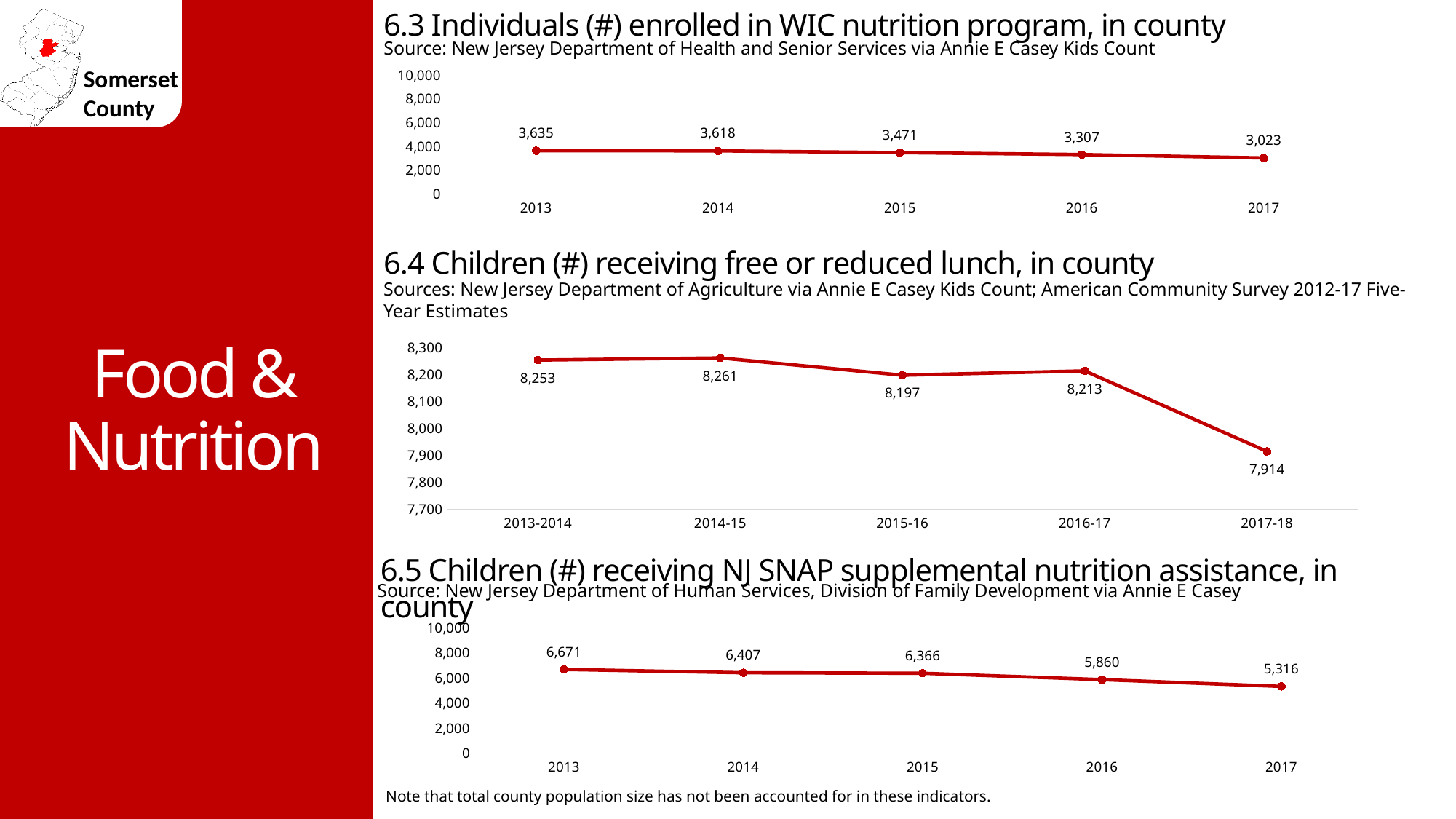
In the chart '6.5 Children (#) receiving NJ SNAP supplemental nutrition assistance, in county', what is the value for 2014? 6,407 In the chart '6.3 Individuals (#) enrolled in WIC nutrition program, in county', which year has the lowest value? 2017 In the chart '6.3 Individuals (#) enrolled in WIC nutrition program, in county', what is the difference between the 2013 and 2017 values? 612 In the chart '6.5 Children (#) receiving NJ SNAP supplemental nutrition assistance, in county', which is larger, the value for 2013 or the value for 2017? 2013 In the chart '6.3 Individuals (#) enrolled in WIC nutrition program, in county', what is the value for 2015? 3,471 In the chart '6.4 Children (#) receiving free or reduced lunch, in county', how many data points are plotted? 5 In the chart '6.3 Individuals (#) enrolled in WIC nutrition program, in county', do the values rise or fall from 2013 to 2017? fall How many charts are shown on the slide? 3 In the chart '6.4 Children (#) receiving free or reduced lunch, in county', what is the value for 2016-17? 8,213 What type of chart is '6.5 Children (#) receiving NJ SNAP supplemental nutrition assistance, in county'? line chart In the chart '6.4 Children (#) receiving free or reduced lunch, in county', which school year has the highest value? 2014-15 In the chart '6.4 Children (#) receiving free or reduced lunch, in county', what is the difference between the 2016-17 and 2017-18 values? 299